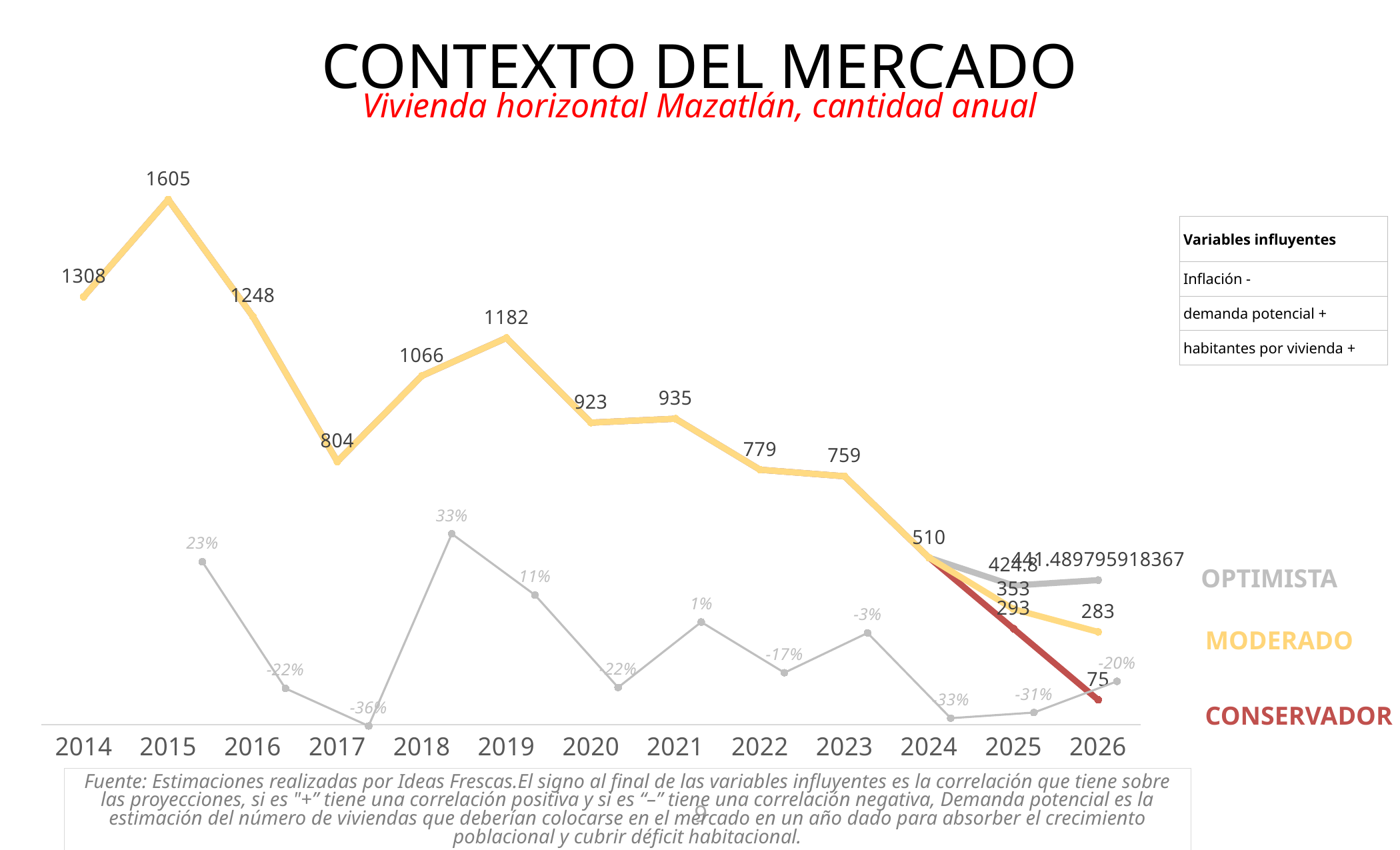
Which is larger, the value for 2020 or the value for 2021? 2021 Which scenario is labelled in red on the chart? CONSERVADOR What is the value for 2024 on the main line? 510 What is the CONSERVADOR projection value for 2026? 75 What kind of chart is shown on the slide? line chart What is the MODERADO projection value for 2026? 283 What percentage change is shown for 2018 on the grey line? 33% What is the CONSERVADOR projection value for 2025? 293 What is the difference between the 2014 value (1308) and the 2015 value (1605)? 297 What is the value for 2015 on the main line? 1605 What is the value for 2017 on the main line? 804 Which year has the highest value on the main line? 2015